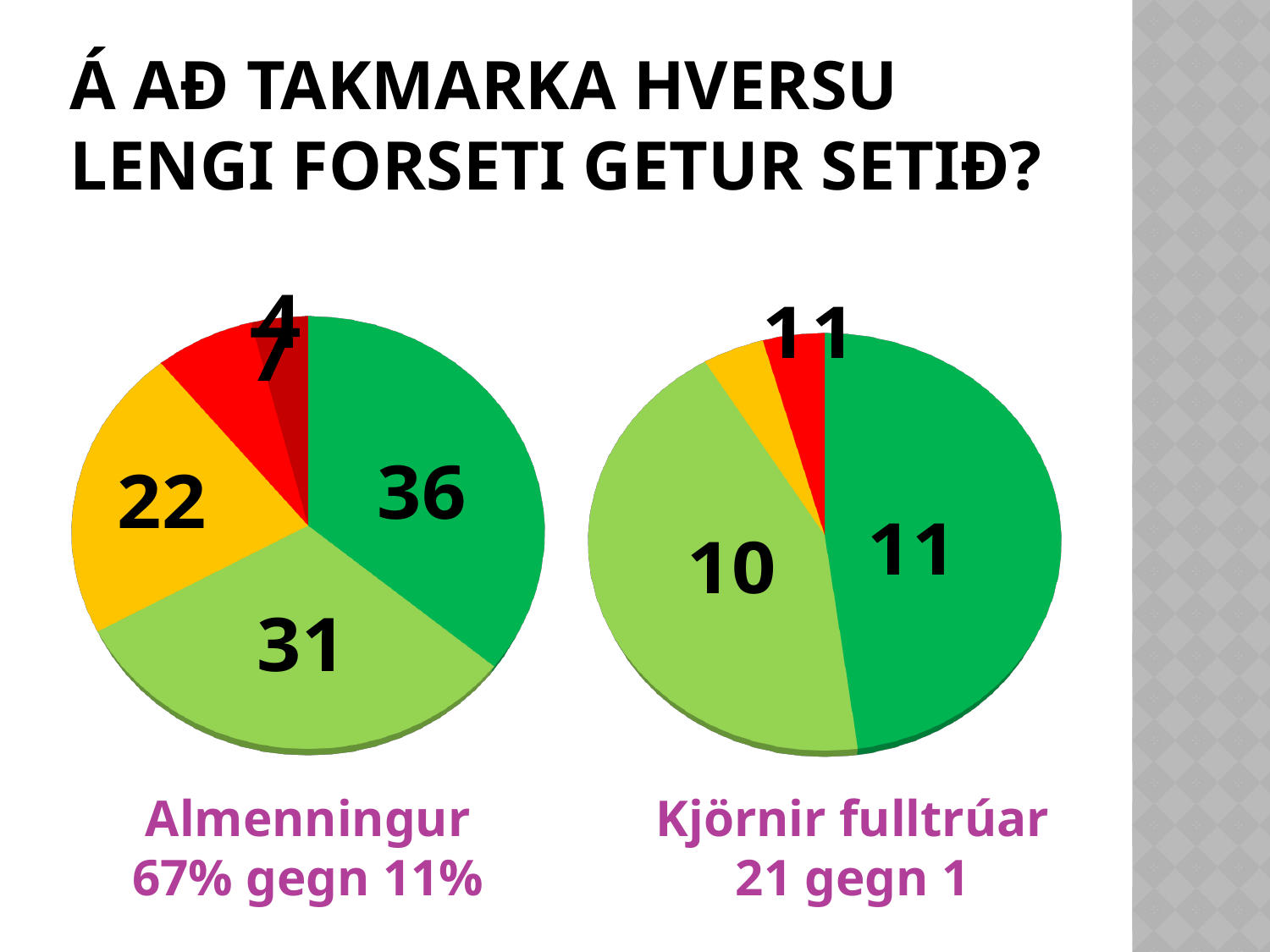
In the right pie chart (Kjörnir fulltrúar), what is the value of the light green slice? 10 In the left pie chart (Almenningur), what is the difference between the dark green slice and the light green slice? 5 What caption is printed under the left pie chart? Almenningur 67% gegn 11% How many slices does the right pie chart (Kjörnir fulltrúar) have? 4 In the left pie chart (Almenningur), what is the value of the yellow slice? 22 In the left pie chart (Almenningur), what is the value of the dark green slice? 36 In the right pie chart (Kjörnir fulltrúar), what is the value of the dark green slice? 11 How many slices does the left pie chart (Almenningur) have? 5 What kind of chart is used on this slide? pie chart In the right pie chart (Kjörnir fulltrúar), which is larger, the dark green slice or the light green slice? the dark green slice In the left pie chart (Almenningur), what is the value of the light green slice? 31 In the left pie chart (Almenningur), which slice is the largest? the dark green slice (36)